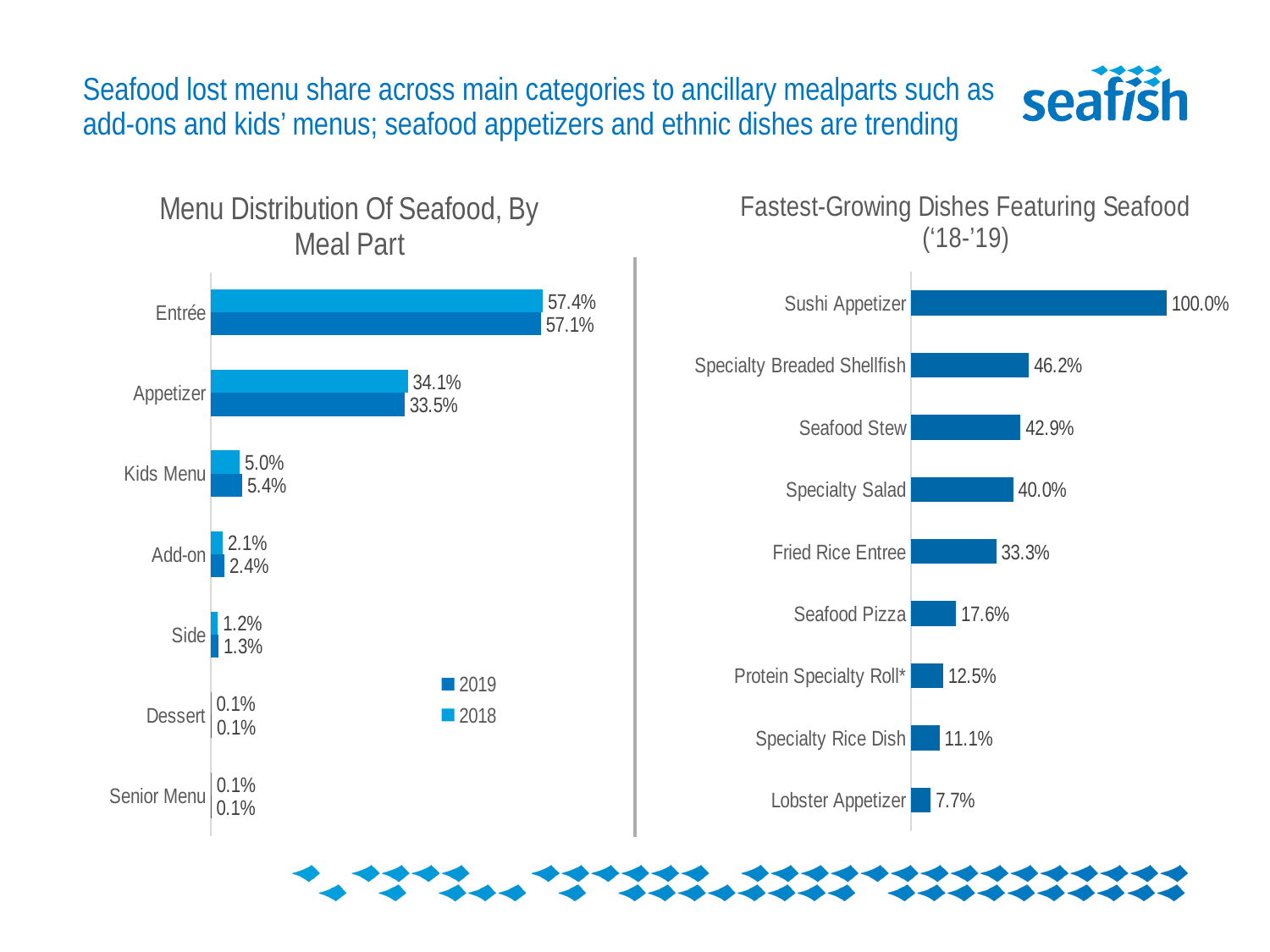
In the 'Fastest-Growing Dishes Featuring Seafood' chart, what is the value for Seafood Stew? 42.9% In the 'Menu Distribution Of Seafood, By Meal Part' chart, what is the 2019 value for Kids Menu? 5.4% In the 'Fastest-Growing Dishes Featuring Seafood' chart, which dish has the highest value? Sushi Appetizer What kind of chart is the 'Fastest-Growing Dishes Featuring Seafood' chart? Bar chart In the 'Menu Distribution Of Seafood, By Meal Part' chart, what is the difference between the 2018 and 2019 values for Appetizer? 0.6% In the 'Menu Distribution Of Seafood, By Meal Part' chart, how many meal part categories are shown? 7 In the 'Menu Distribution Of Seafood, By Meal Part' chart, which is larger for Add-on: the 2019 value or the 2018 value? 2019 In the 'Menu Distribution Of Seafood, By Meal Part' chart, what is the 2019 value for Appetizer? 33.5% In the 'Menu Distribution Of Seafood, By Meal Part' chart, what is the 2018 value for Entrée? 57.4% In the 'Menu Distribution Of Seafood, By Meal Part' chart, how many series does the legend list? 2 In the 'Fastest-Growing Dishes Featuring Seafood' chart, which dish has the lowest value? Lobster Appetizer In the 'Fastest-Growing Dishes Featuring Seafood' chart, what is the difference between Specialty Breaded Shellfish and Specialty Salad? 6.2%